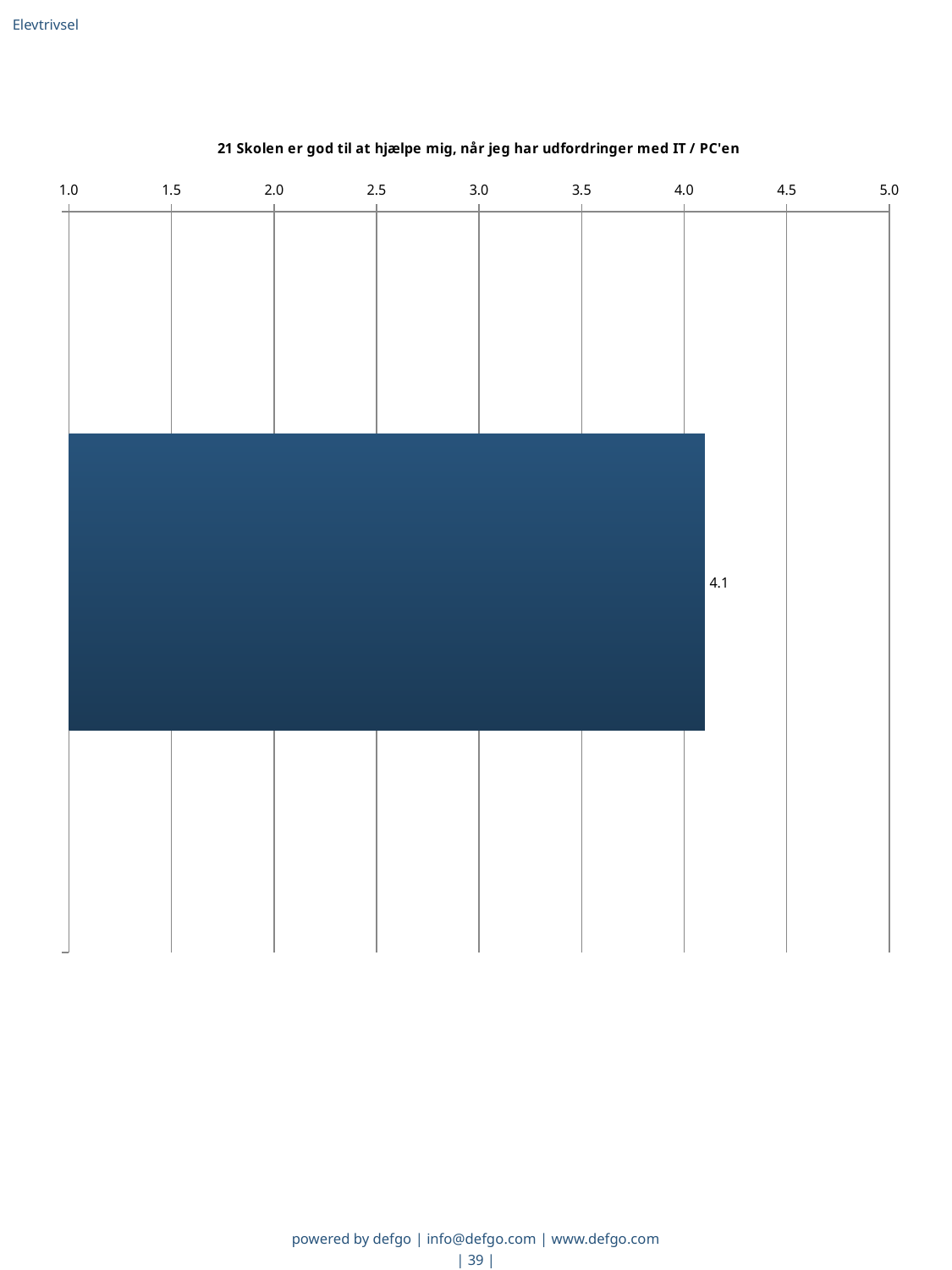
What value is shown by the data label on the bar? 4.1 What is the title of the chart? 21 Skolen er god til at hjælpe mig, når jeg har udfordringer med IT / PC'en What kind of chart is shown on the slide? bar chart What is the highest value shown on the chart's axis? 5.0 Are the bars in the chart horizontal or vertical? horizontal Is the value of the bar greater or less than 4.5? less Is the value of the bar greater or less than 3.0? greater Is the value of the bar greater or less than 4.0? greater How many bars are plotted in the chart? 1